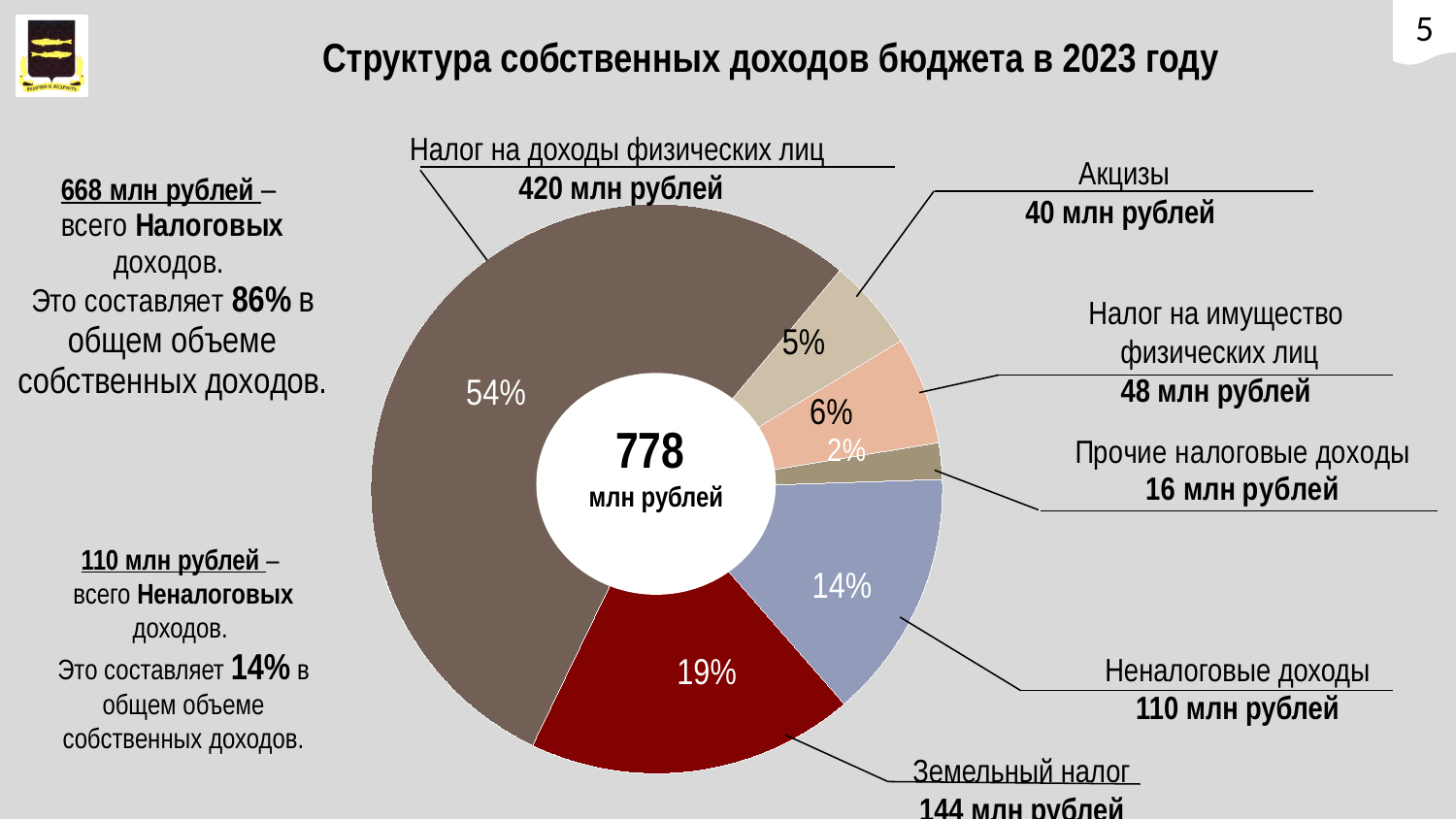
What share of the pie does Неналоговые доходы take? 14% What total is shown in the centre of the chart? 778 млн рублей Which category has the largest slice? Налог на доходы физических лиц What is the value for Налог на доходы физических лиц? 420 млн рублей What is the value for Акцизы? 40 млн рублей How many categories does the chart show? 6 Which is larger, Акцизы or Налог на имущество физических лиц? Налог на имущество физических лиц Which category has the smallest slice? Прочие налоговые доходы What is the difference between Земельный налог and Неналоговые доходы? 34 млн рублей What share of the pie does Налог на имущество физических лиц take? 6% What is the value for Земельный налог? 144 млн рублей What kind of chart is shown on the slide? Pie (doughnut) chart